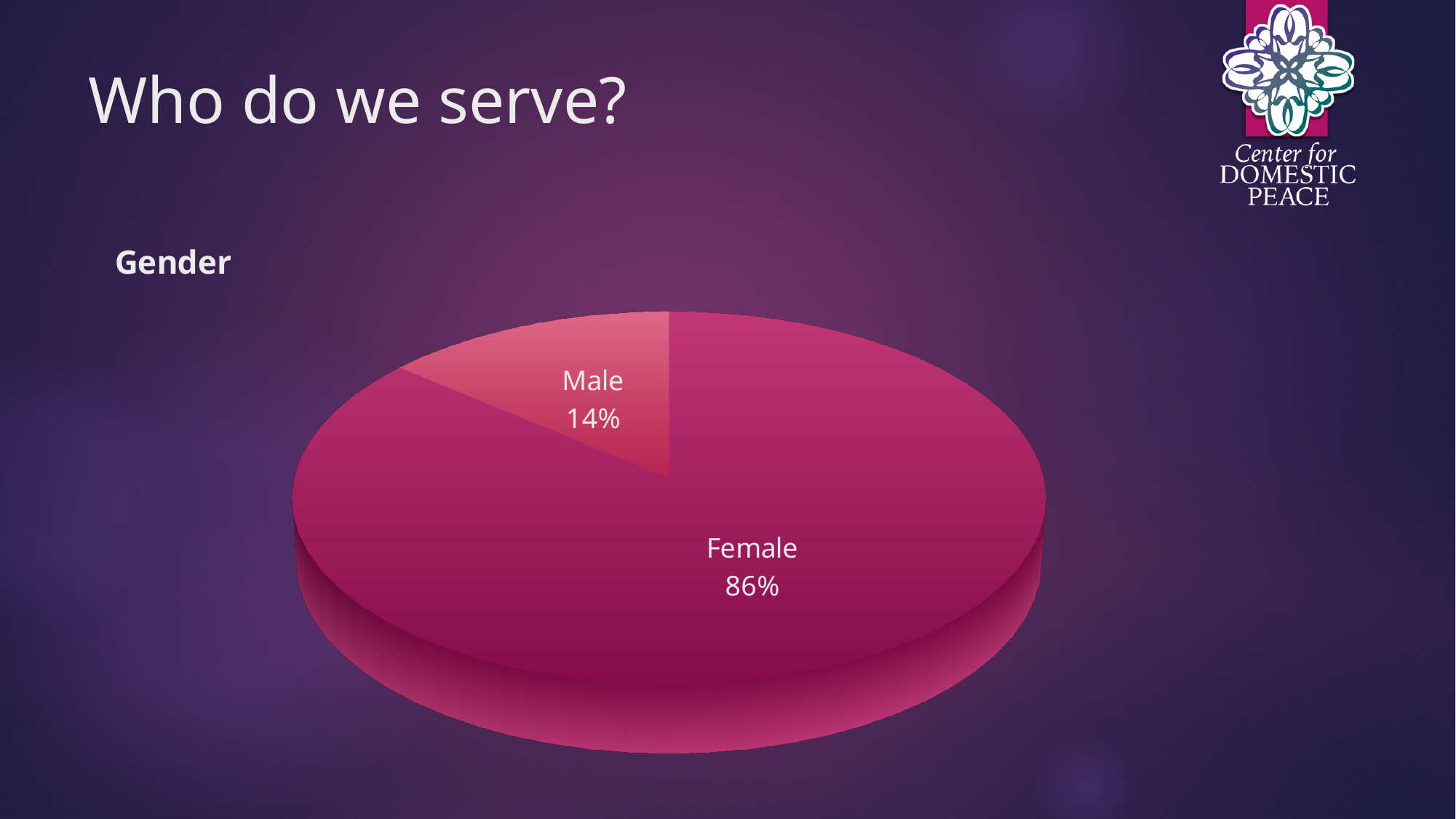
Which slice is larger, Male or Female? Female Which category has the smallest slice of the pie? Male What share of the pie does Male represent? 14% What is the title of the chart? Gender What kind of chart is shown on the slide? Pie chart How many categories are shown in the pie chart? 2 What is the total of the two slices shown in the pie chart? 100% What is the difference in percentage points between the Female and Male slices? 72 Which category has the largest slice of the pie? Female What share of the pie does Female represent? 86%